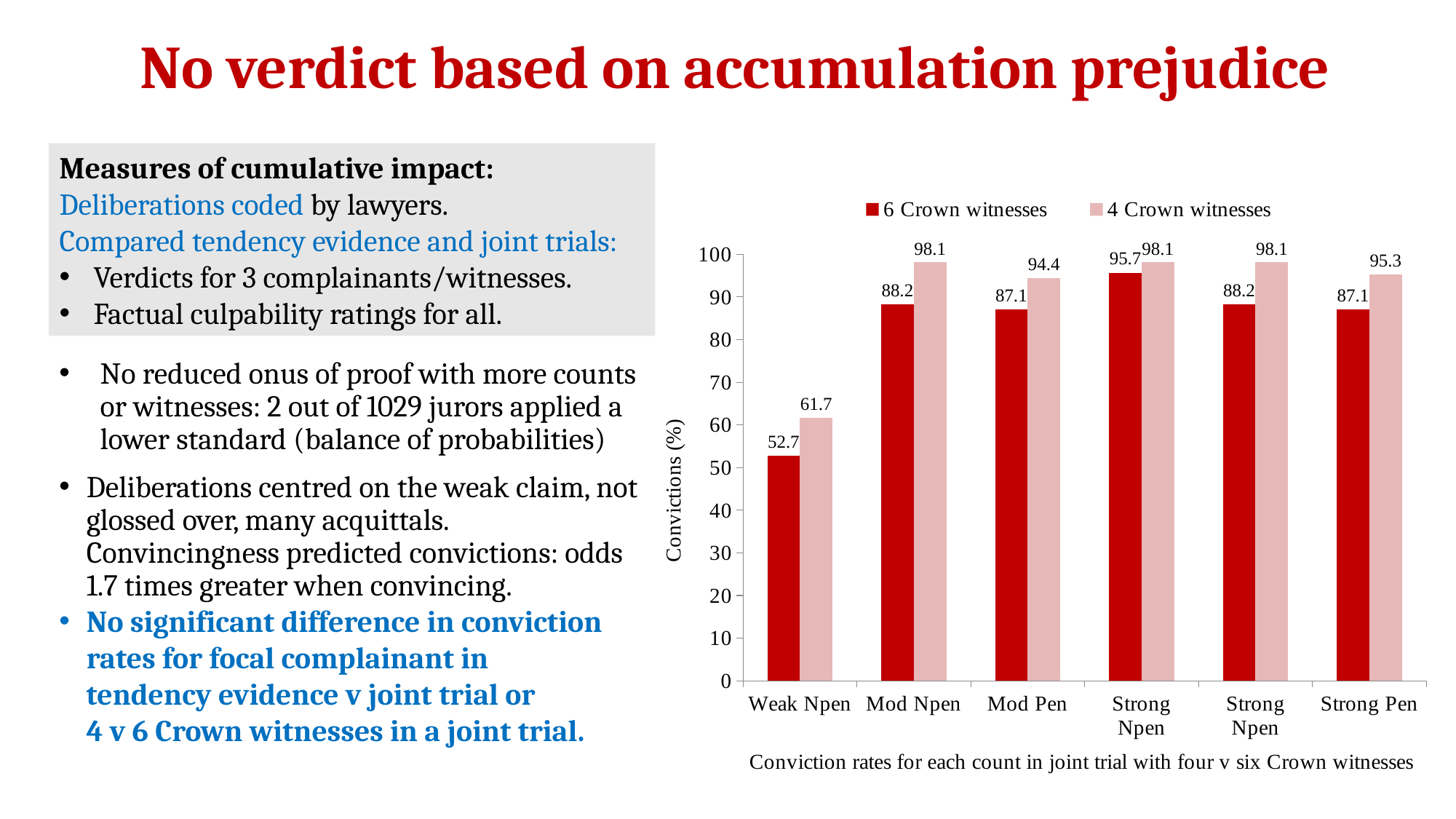
Is the conviction rate for 6 Crown witnesses in the Weak Npen condition greater or less than 60? less For 4 Crown witnesses, which is higher: Weak Npen or Mod Npen? Mod Npen What is the difference between the 4 Crown witnesses and 6 Crown witnesses conviction rates in the Mod Pen condition? 7.3 What is the conviction rate for 6 Crown witnesses in the Weak Npen condition? 52.7 How many series does the chart legend list? 2 What is the difference between the 4 Crown witnesses and 6 Crown witnesses conviction rates in the Weak Npen condition? 9.0 What is the conviction rate for 6 Crown witnesses in the Mod Npen condition? 88.2 How many categories are shown on the x axis of the chart? 6 What is the conviction rate for 4 Crown witnesses in the Mod Pen condition? 94.4 Which category has the lowest conviction rate for 6 Crown witnesses? Weak Npen What is the conviction rate for 4 Crown witnesses in the Strong Pen condition? 95.3 What kind of chart is shown on the slide? bar chart